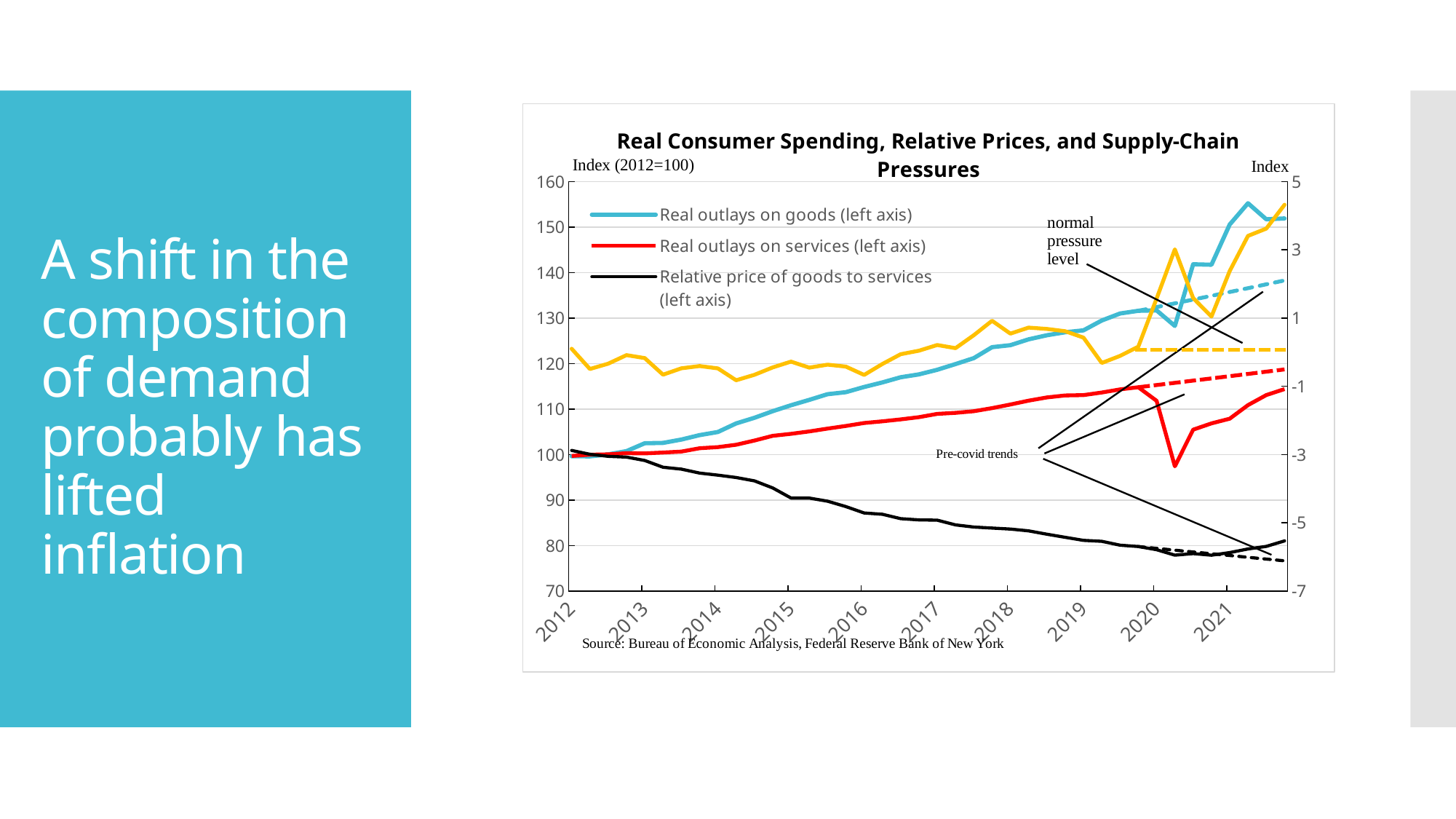
What kind of chart is shown on the slide? line chart Is the value for Real outlays on services at the start of 2019 greater or less than 120? less Is the value for Relative price of goods to services at the start of 2021 greater or less than 90? less How many year labels are shown on the x axis? 10 Does the Real outlays on goods line generally rise or fall from 2012 to 2021? rise Is the value for Real outlays on goods at the end of 2021 greater or less than 140? greater Does the Relative price of goods to services line generally rise or fall from 2012 to 2020? fall How many series does the chart's legend list? 3 At the end of 2021, which is higher: Real outlays on goods or Real outlays on services? Real outlays on goods What is the title of the chart? Real Consumer Spending, Relative Prices, and Supply-Chain Pressures What do the dashed lines on the chart represent, according to the annotation? Pre-covid trends